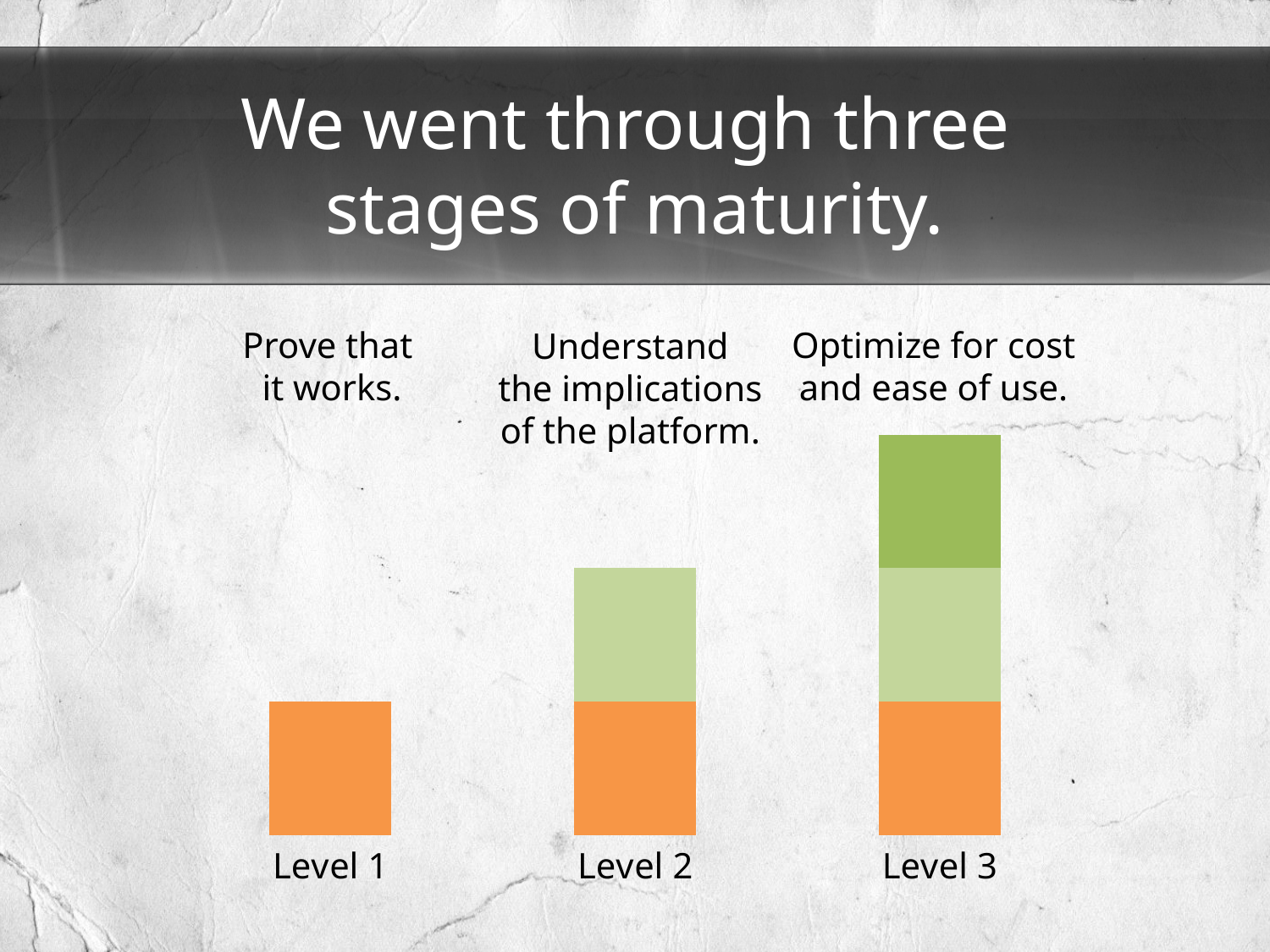
How many stacked segments does the Level 3 bar have? 3 Which bar is taller, Level 1 or Level 2? Level 2 Which category has the tallest bar in the chart? Level 3 What colour is the bottom segment of each bar in the chart? Orange What is the title of the slide containing the chart? We went through three stages of maturity. What kind of chart is shown on the slide? Stacked bar chart Which bar is taller, Level 2 or Level 3? Level 3 What is the label of the first category on the x axis? Level 1 Do the bar heights rise or fall from Level 1 to Level 3? Rise How many categories are shown on the x axis of the chart? 3 Which category has the shortest bar in the chart? Level 1 How many stacked segments does the Level 2 bar have? 2